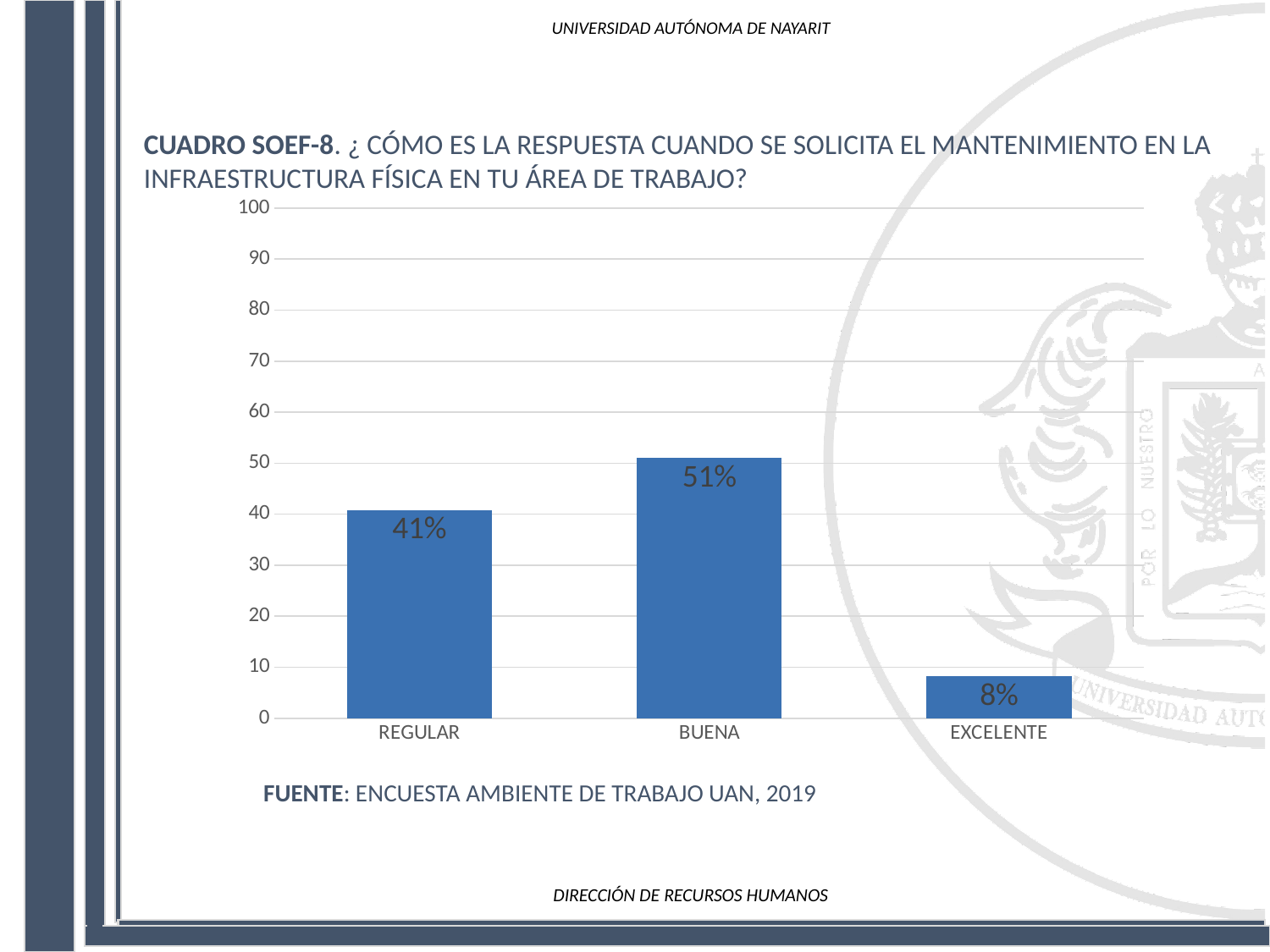
Which category has the lowest value? EXCELENTE What is the difference between the values for BUENA and REGULAR? 10% What is the value for REGULAR? 41% What kind of chart is shown on the slide? bar chart How many categories are shown on the x axis? 3 Which category has the highest value? BUENA What is the value for BUENA? 51% Is the value for BUENA greater or less than 50? greater What is the difference between the values for REGULAR and EXCELENTE? 33% Which is larger, the value for REGULAR or the value for EXCELENTE? REGULAR What is the value for EXCELENTE? 8% What source is cited below the chart? ENCUESTA AMBIENTE DE TRABAJO UAN, 2019